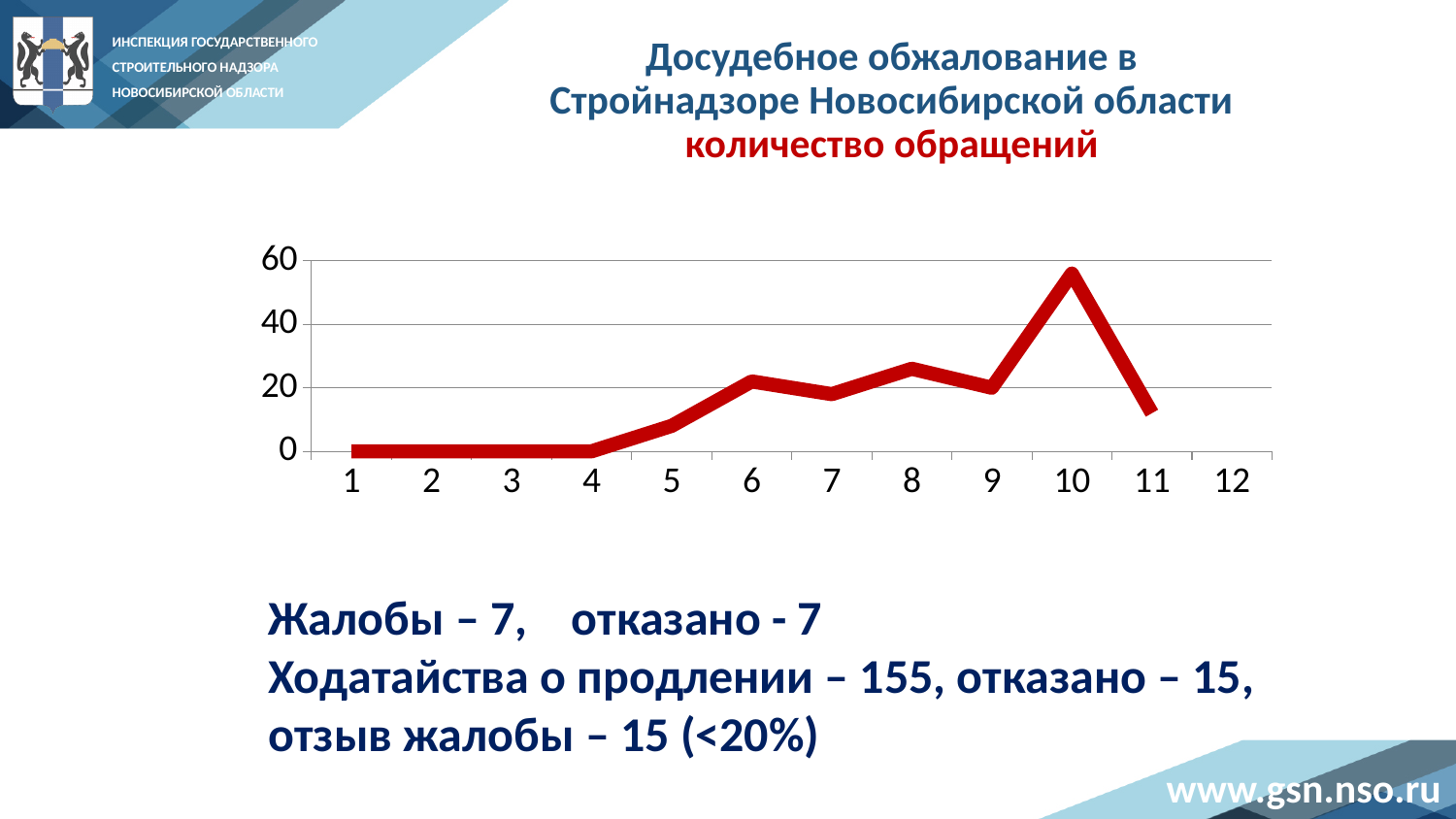
Is the value for category 5 greater or less than 20? less Is the value for category 11 greater or less than 20? less Which is larger, the value for category 6 or the value for category 5? 6 Which category has the highest value? 10 Does the line rise or fall from category 10 to category 11? fall Is the value for category 10 greater or less than 40? greater What is the value for category 1? 0 Which is larger, the value for category 10 or the value for category 8? 10 What kind of chart is shown on the slide? line chart What is the value for category 4? 0 How many categories are labelled on the x axis? 12